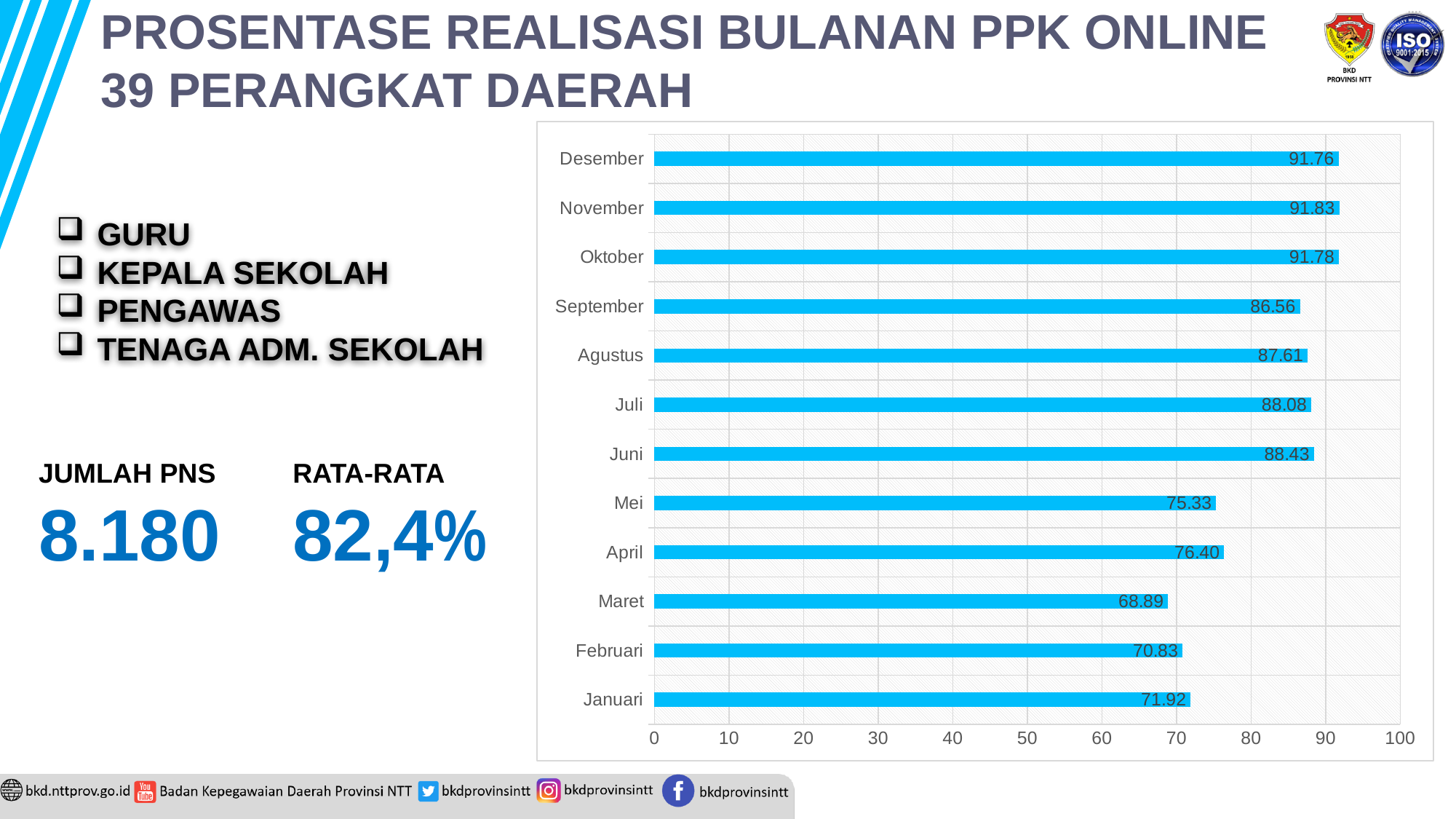
What is the value for Desember? 91.76 Is the value for Maret greater or less than 70? less How many months are shown in the chart? 12 What is the difference between the values for Juni and Mei? 13.10 What is the value for September? 86.56 Is the value for Agustus greater or less than 80? greater What is the value for Mei? 75.33 Which month has the lowest value? Maret What is the highest tick value shown on the horizontal axis? 100 What is the difference between the values for Desember and Januari? 19.84 What kind of chart is shown on the slide? bar chart Which is larger, the value for Juli or the value for Maret? Juli